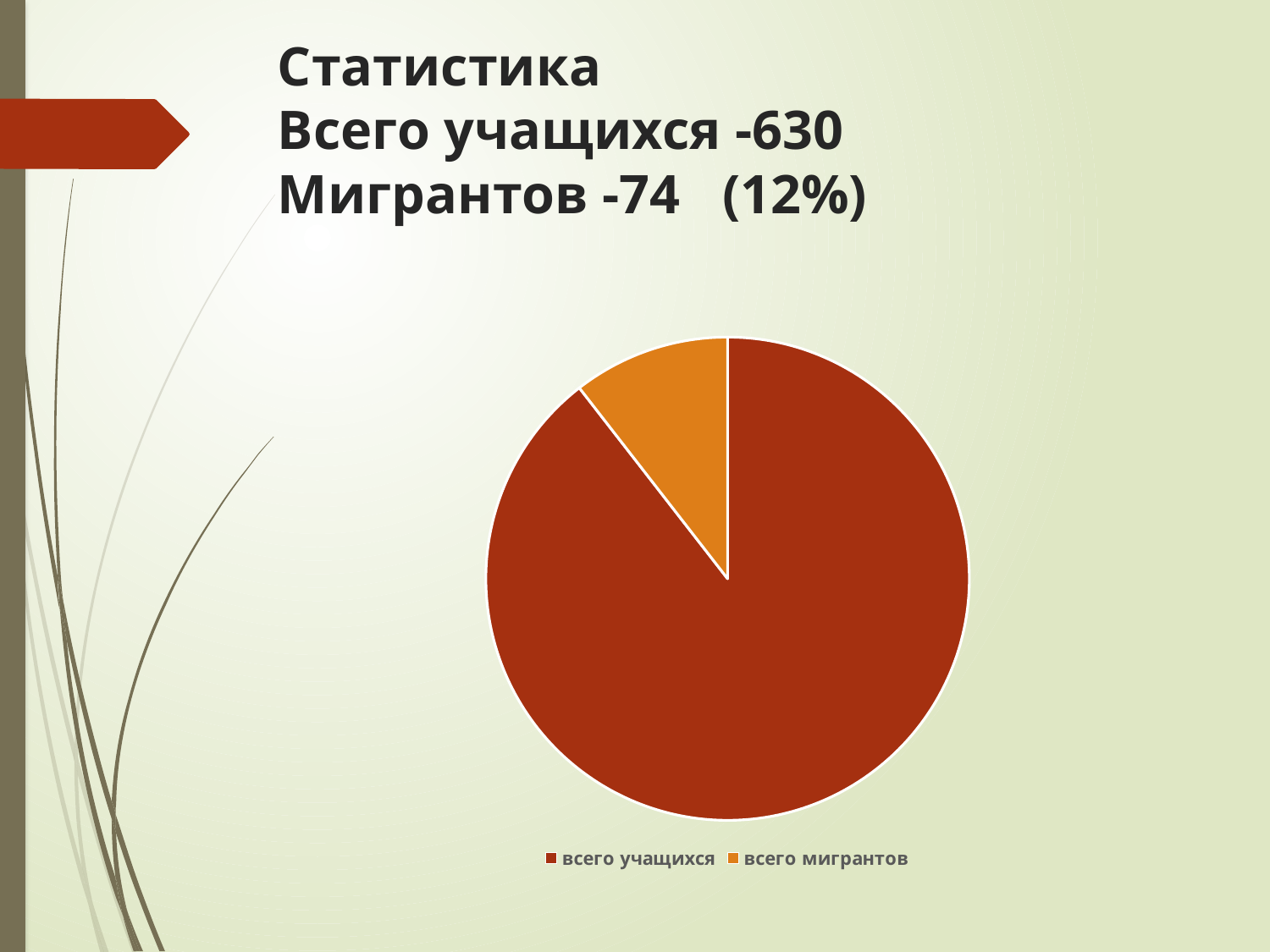
Which slice of the pie chart is the largest? всего учащихся What colour is the "всего мигрантов" slice in the pie chart? orange How many slices does the pie chart have? 2 Which slice is larger in the pie chart, "всего учащихся" or "всего мигрантов"? всего учащихся How many entries does the legend of the pie chart list? 2 What colour is the "всего учащихся" slice in the pie chart? dark red What kind of chart is shown on the slide? pie chart Which slice of the pie chart is the smallest? всего мигрантов